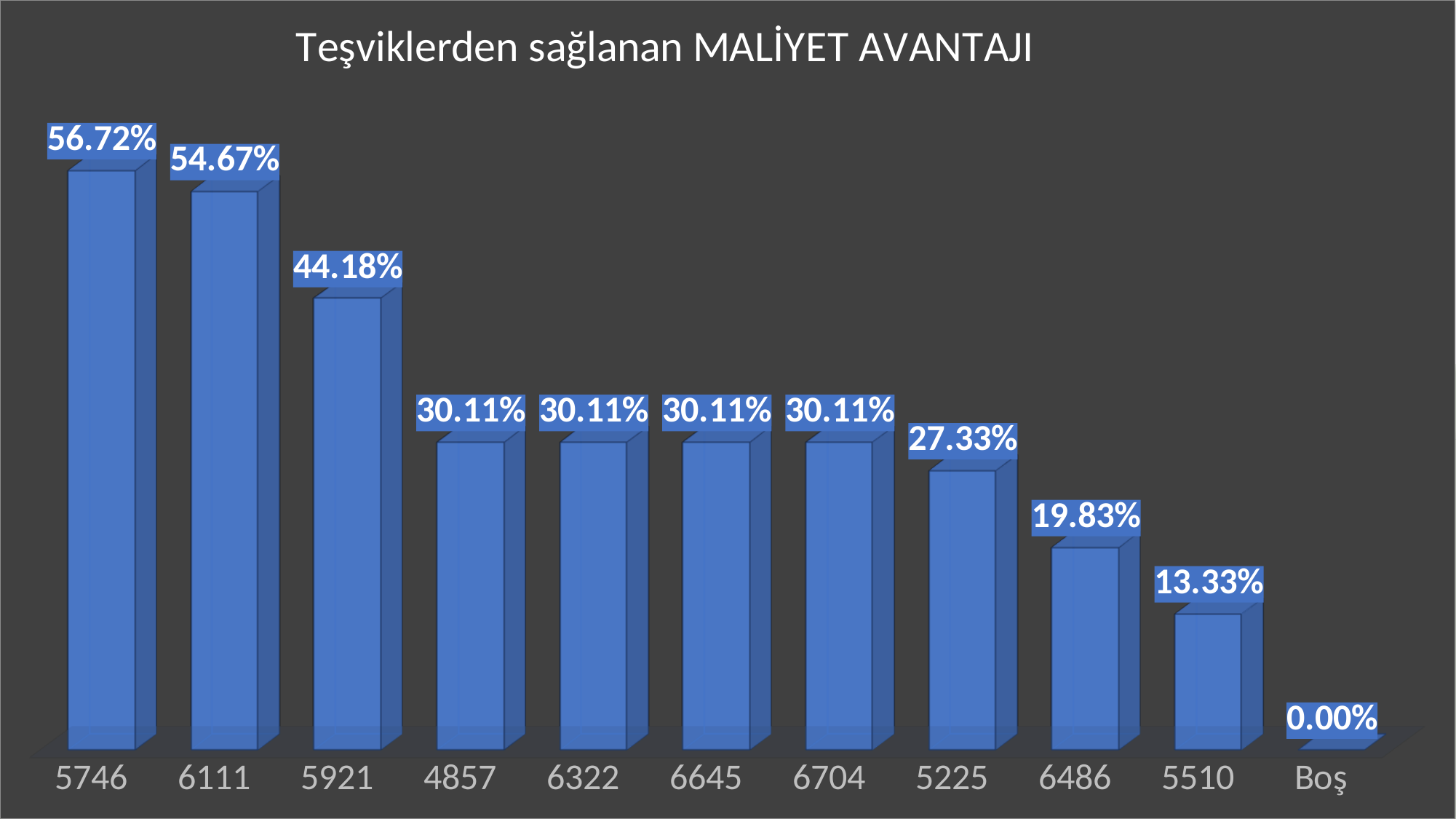
What kind of chart is this? bar chart What is the difference between the values for 5225 and 5510? 14.00% What is the value for category Boş? 0.00% Which category has the highest value? 5746 What is the difference between the values for 5746 and 6111? 2.05% How many categories are shown on the x axis? 11 What is the value for category 5746? 56.72% Which is larger, the value for 5921 or the value for 4857? 5921 What is the value for category 5921? 44.18% What is the value for category 6486? 19.83% What is the title of the chart? Teşviklerden sağlanan MALİYET AVANTAJI Which category has the lowest value? Boş